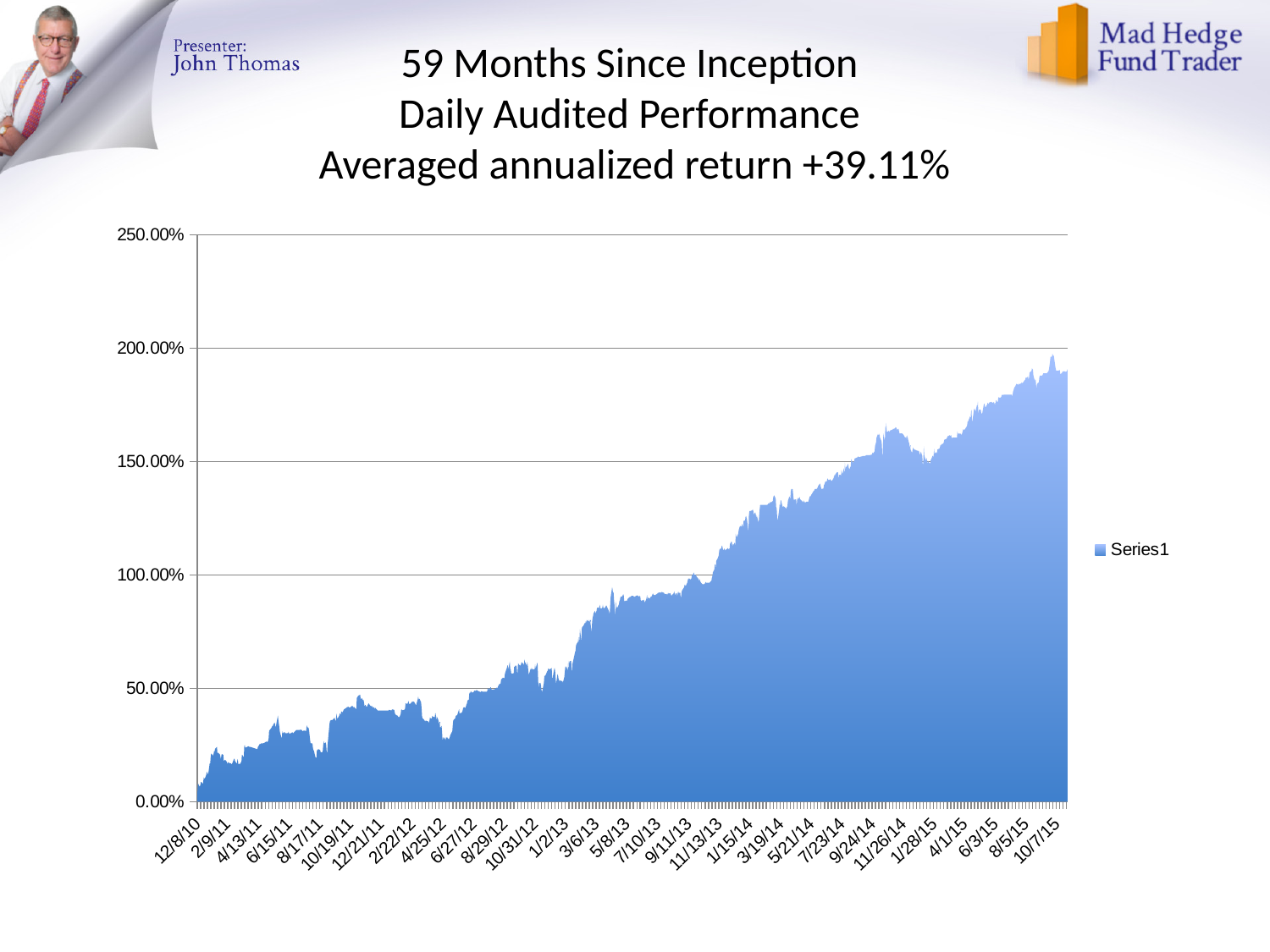
Is the value at 10/7/15 greater or less than 150.00%? greater Is the value at 4/25/12 greater or less than 50.00%? less Is the value at 1/2/13 greater or less than 100.00%? less Do the values generally rise or fall from 12/8/10 to 10/7/15? rise How many series does the legend list? 1 What kind of chart is shown on the slide? area chart Which date has the larger value, 6/27/12 or 1/15/14? 1/15/14 What is the averaged annualized return stated in the chart title? +39.11% What is the name of the series shown in the legend? Series1